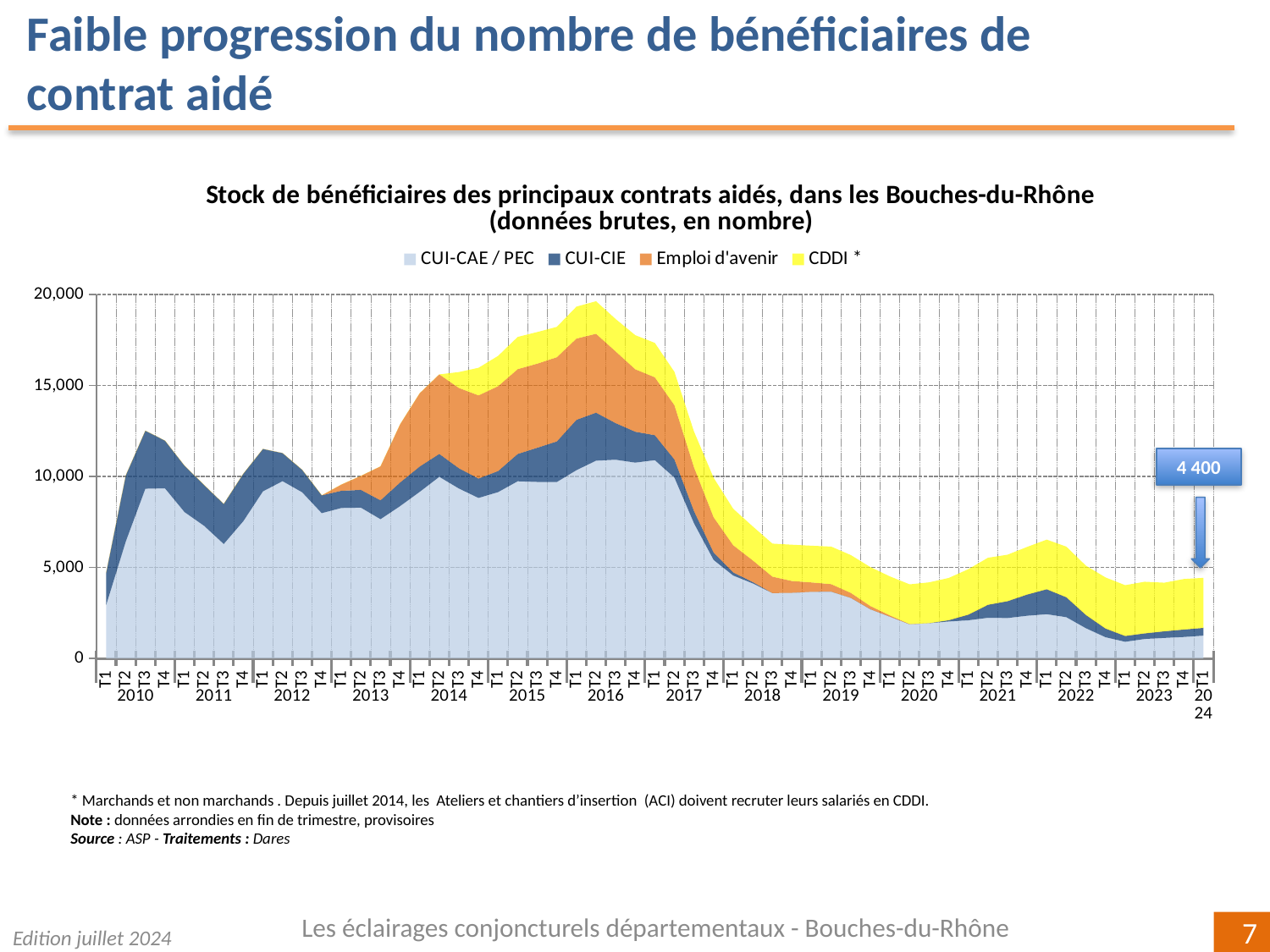
Which series is shown in yellow in the chart? CDDI * Which series is shown in orange in the chart? Emploi d'avenir Is the total stock of beneficiaries at T3 2010 greater or less than 10,000? greater Which is larger, the total stock of beneficiaries at T2 2016 or at T1 2024? T2 2016 How many series does the legend of the chart list? 4 What is the total stock of beneficiaries shown for T1 2024 in the chart? 4 400 In which year does the total stock of beneficiaries reach its highest level? 2016 Is the total stock of beneficiaries at T2 2020 greater or less than 5,000? less Is the total stock of beneficiaries at T2 2016 greater or less than 15,000? greater What kind of chart is used to show the stock of beneficiaries of contrats aidés? Stacked area chart Does the total stock of beneficiaries rise or fall between 2016 and 2018? Fall